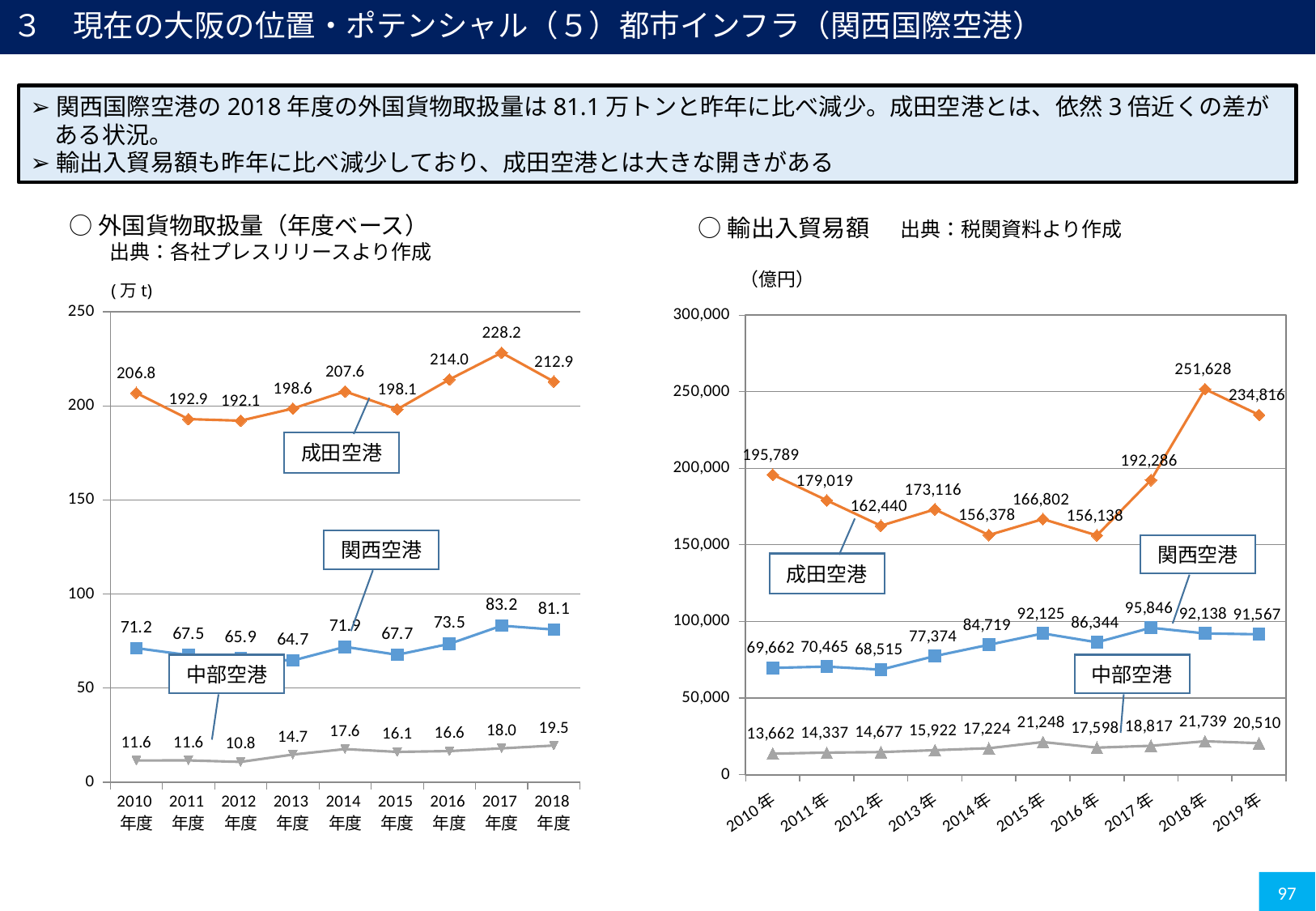
In the 外国貨物取扱量（年度ベース） chart, in which year is the value for 中部空港 highest? 2018年度 In the 外国貨物取扱量（年度ベース） chart, what is the difference between 成田空港 and 関西空港 in 2018年度? 131.8 In the 輸出入貿易額 chart, which is larger for 関西空港: the value in 2015年 or the value in 2016年? 2015年 In the 外国貨物取扱量（年度ベース） chart, what is the value for 関西空港 in 2018年度? 81.1 In the 輸出入貿易額 chart, what is the value for 中部空港 in 2019年? 20,510 In the 外国貨物取扱量（年度ベース） chart, in which year is the value for 関西空港 lowest? 2013年度 In the 輸出入貿易額 chart, what is the value for 成田空港 in 2018年? 251,628 In the 外国貨物取扱量（年度ベース） chart, how many fiscal years are shown on the x axis? 9 In the 外国貨物取扱量（年度ベース） chart, what is the value for 成田空港 in 2017年度? 228.2 In the 輸出入貿易額 chart, what is the difference between 成田空港 and 関西空港 in 2019年? 143,249 What kind of chart is the 輸出入貿易額 chart? line chart In the 輸出入貿易額 chart, in which year is the value for 関西空港 highest? 2017年